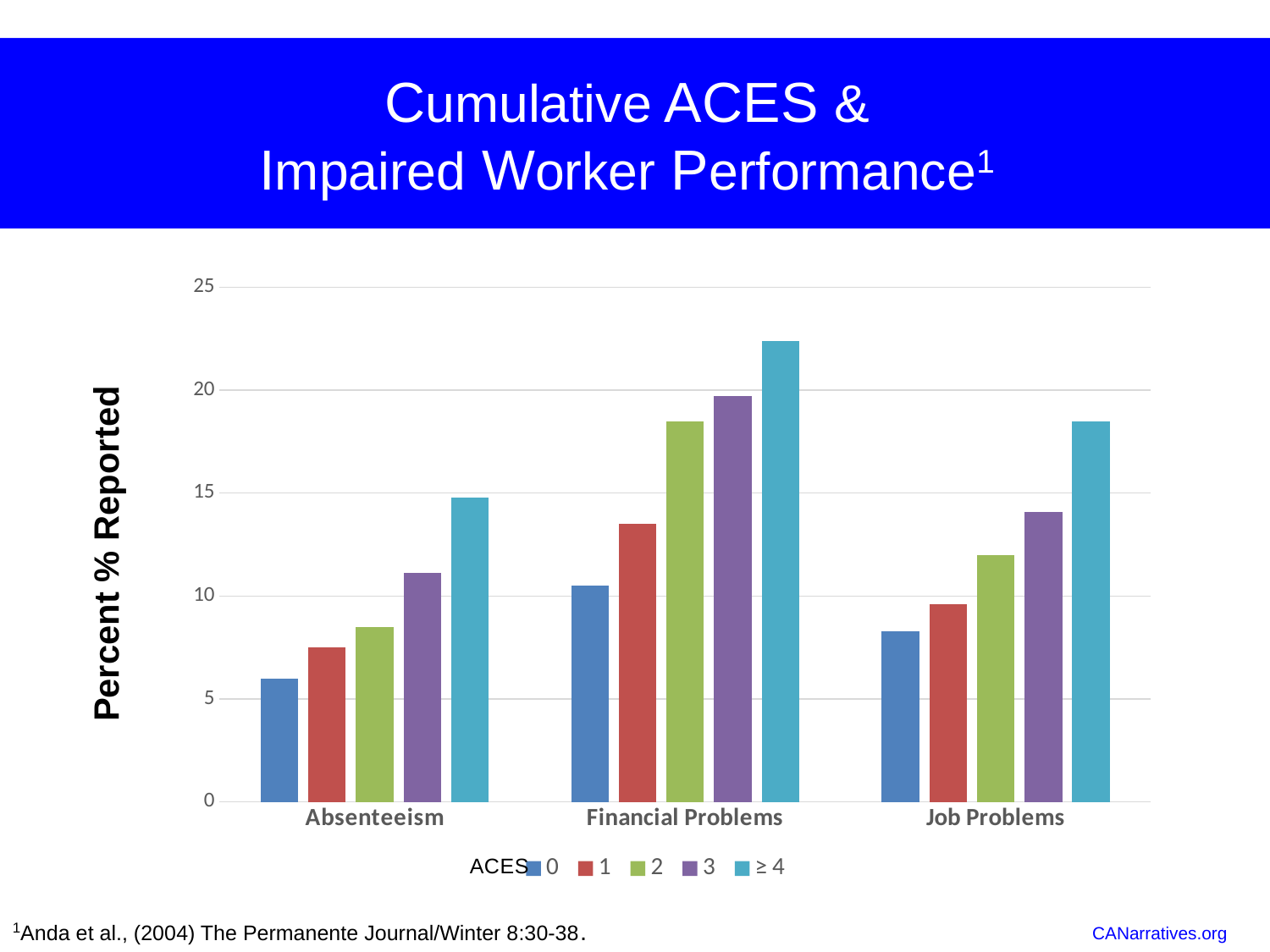
How many categories are shown on the x axis? 3 Within each category, do the bars rise or fall as the number of ACES increases from 0 to ≥ 4? rise How many series does the legend list? 5 Is the value for 0 ACES in Absenteeism greater or less than 10? less What kind of chart is shown on the slide? bar chart Which category has the lowest bar for the 0 ACES series? Absenteeism Which is larger: the ≥ 4 ACES value for Financial Problems or the ≥ 4 ACES value for Job Problems? Financial Problems Is the value for ≥ 4 ACES in Absenteeism greater or less than 10? greater Is the value for ≥ 4 ACES in Financial Problems greater or less than 20? greater What is the title of the y axis? Percent % Reported Which category has the highest bar for the ≥ 4 ACES series? Financial Problems